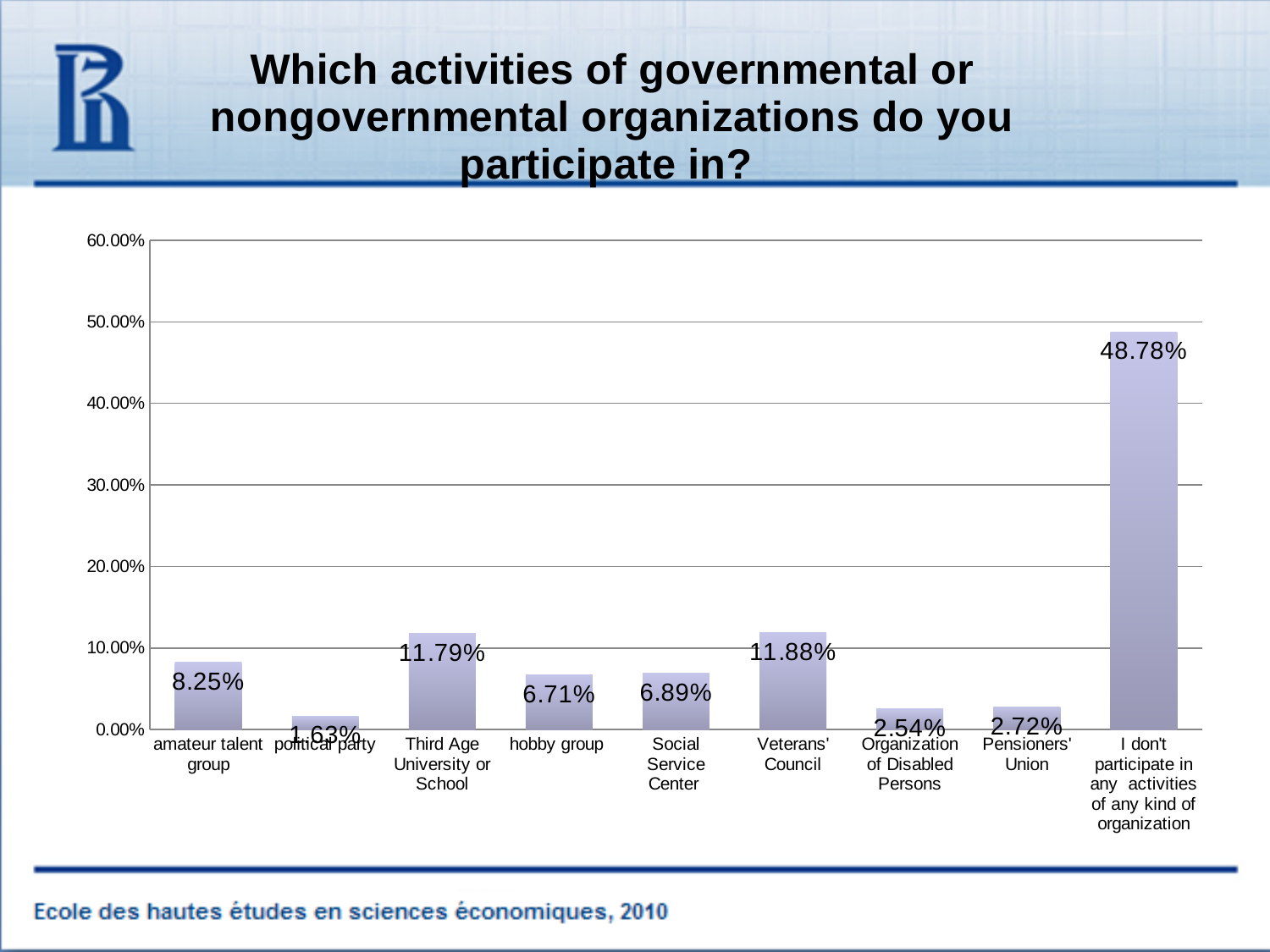
What percentage of respondents participate in a hobby group? 6.71% What is the difference between the values for Social Service Center and hobby group? 0.18% Which category has the highest value? I don't participate in any activities of any kind of organization What kind of chart is shown on the slide? bar chart Which category has the lowest value? political party How many categories are shown on the x axis? 9 What is the value shown for Veterans' Council? 11.88% Which is larger, the value for Third Age University or School or the value for amateur talent group? Third Age University or School What percentage of respondents don't participate in any activities of any kind of organization? 48.78% What is the value for Pensioners' Union? 2.72% Is the value for Organization of Disabled Persons greater or less than 10.00%? less What is the difference between the values for amateur talent group and political party? 6.62%